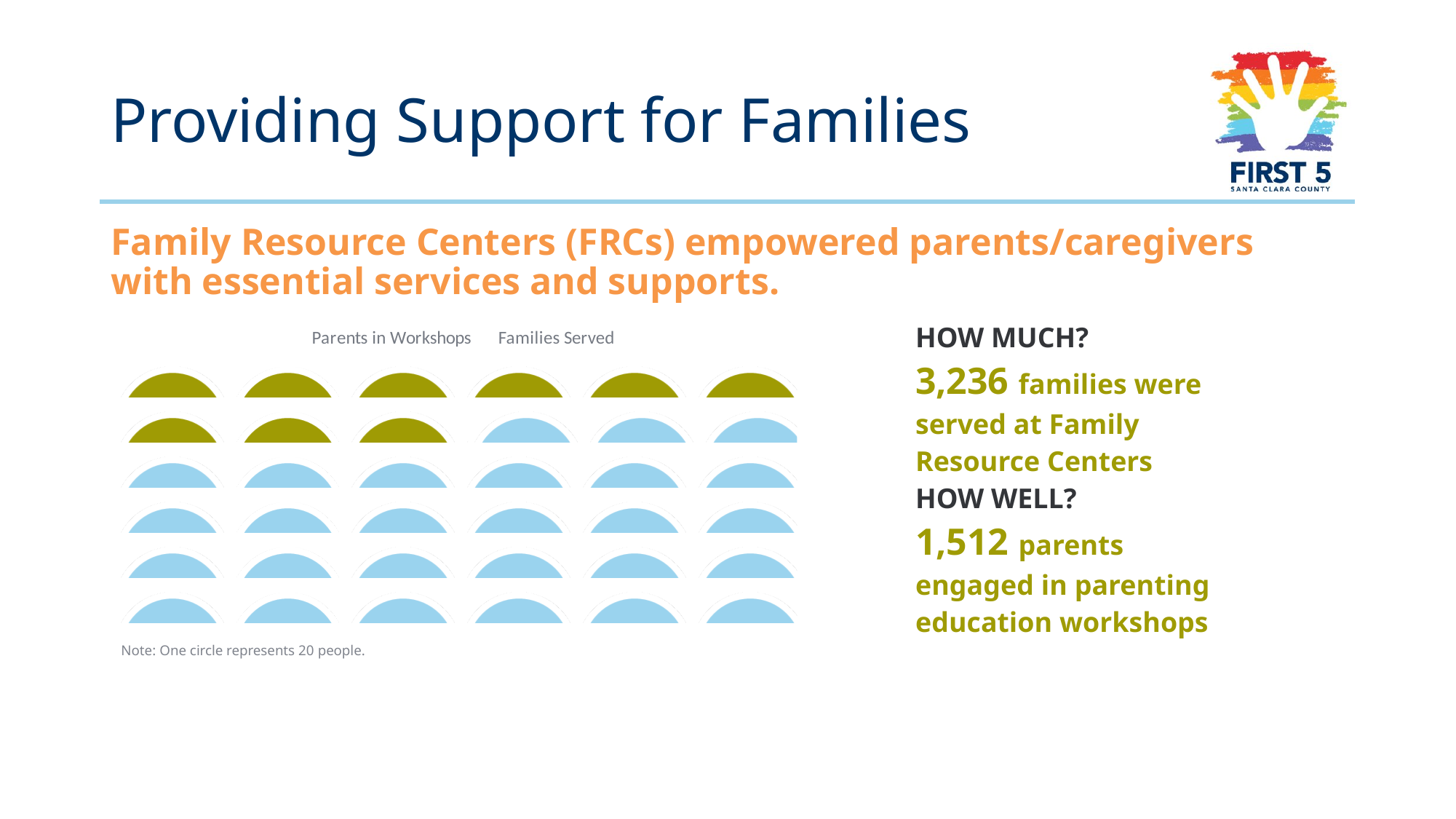
Is the number of families served greater or less than 3,000? greater What are the two series named in the chart legend? Parents in Workshops and Families Served According to the slide, how many families were served at Family Resource Centers? 3,236 What kind of chart is shown on the slide? Pictograph (icon chart) How many circle icons are shown in the chart grid in total? 36 Which is larger, the number of families served or the number of parents in workshops? Families served How many olive-coloured circles (Parents in Workshops) are shown in the chart? 9 How many light blue circles (Families Served) are shown in the chart? 27 According to the slide, how many parents engaged in parenting education workshops? 1,512 What is the difference between the number of families served (3,236) and the number of parents in workshops (1,512)? 1,724 How many series does the chart legend list? 2 How many people does one circle in the chart represent? 20